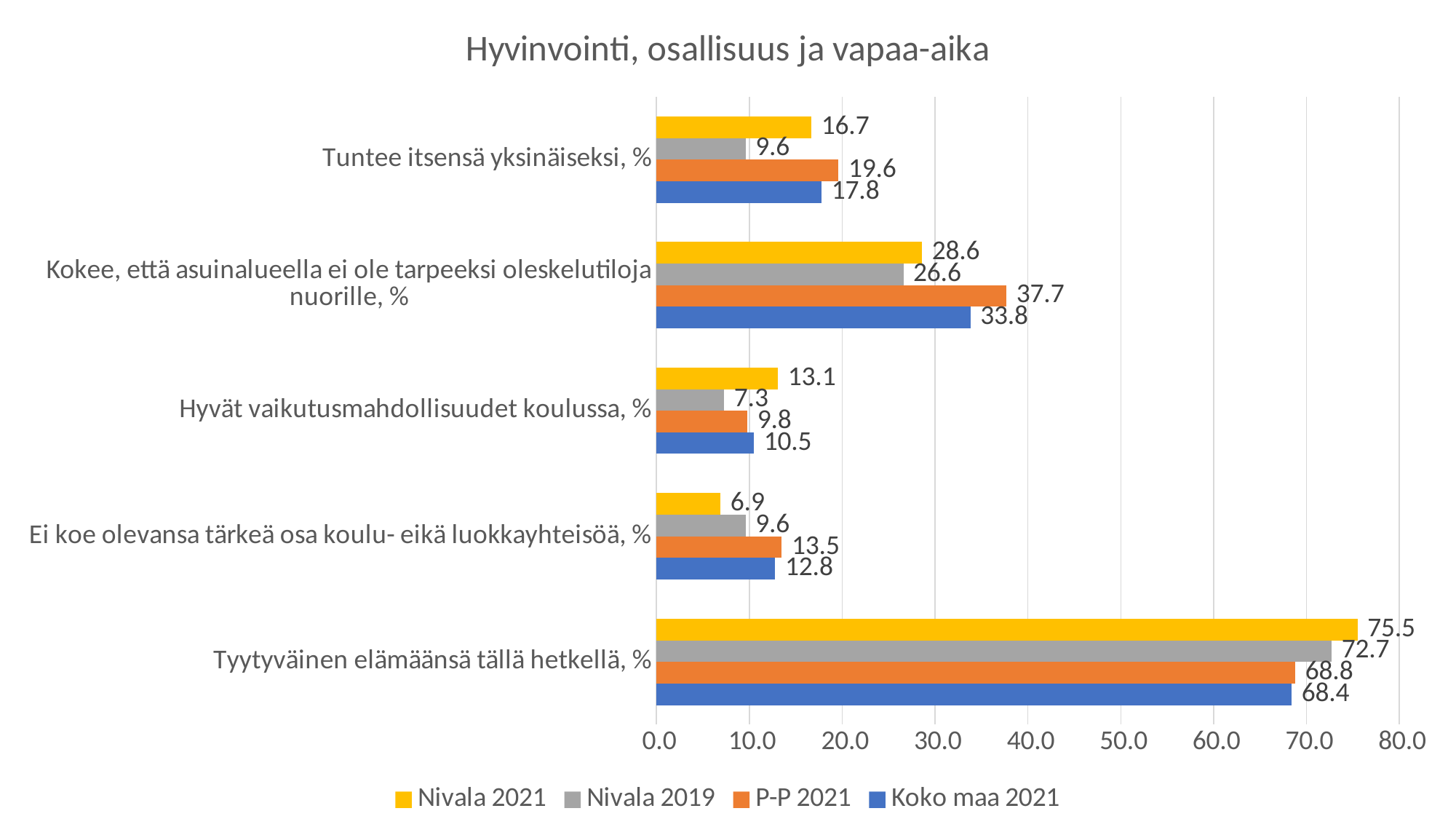
What kind of chart is shown on the slide? Bar chart Which is larger in the category 'Kokee, että asuinalueella ei ole tarpeeksi oleskelutiloja nuorille, %': the P-P 2021 value or the Koko maa 2021 value? P-P 2021 What is the title of the chart? Hyvinvointi, osallisuus ja vapaa-aika What is the value for P-P 2021 in the category 'Kokee, että asuinalueella ei ole tarpeeksi oleskelutiloja nuorille, %'? 37.7 How many categories are shown on the chart? 5 How many series does the legend list? 4 What is the difference between the Nivala 2021 and Nivala 2019 values in the category 'Tuntee itsensä yksinäiseksi, %'? 7.1 Which series has the lowest value in the category 'Ei koe olevansa tärkeä osa koulu- eikä luokkayhteisöä, %'? Nivala 2021 Which series has the highest value in the category 'Tyytyväinen elämäänsä tällä hetkellä, %'? Nivala 2021 What is the value for Nivala 2019 in the category 'Hyvät vaikutusmahdollisuudet koulussa, %'? 7.3 What is the value for Nivala 2021 in the category 'Tuntee itsensä yksinäiseksi, %'? 16.7 What is the value for Koko maa 2021 in the category 'Tyytyväinen elämäänsä tällä hetkellä, %'? 68.4